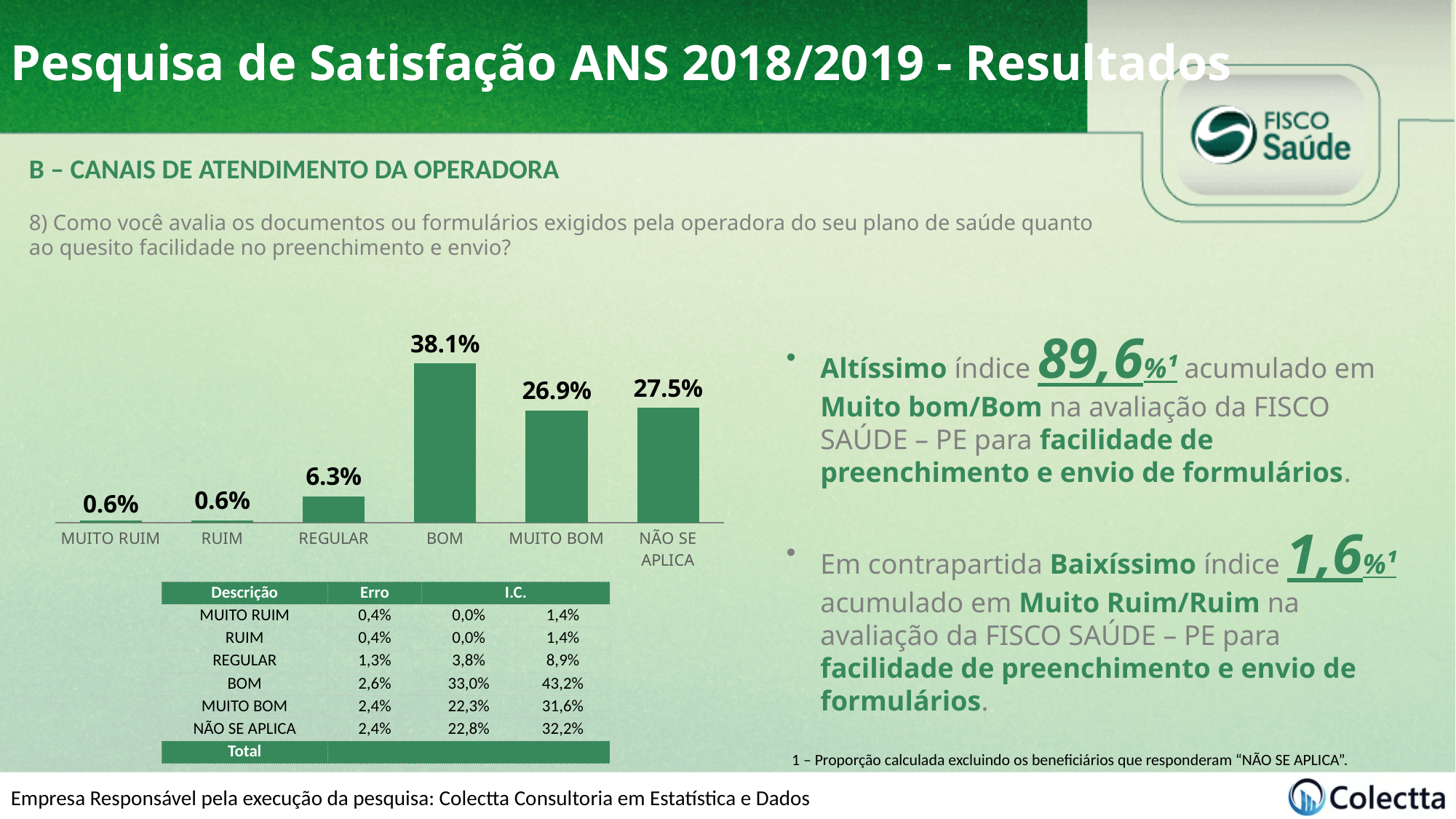
What is the combined value of BOM and MUITO BOM? 65.0% What is the value for MUITO BOM? 26.9% What is the difference between the values for BOM and MUITO BOM? 11.2% What is the value for BOM? 38.1% What is the value for NÃO SE APLICA? 27.5% What is the difference between the values for NÃO SE APLICA and REGULAR? 21.2% What is the value for REGULAR? 6.3% Which is larger, the value for NÃO SE APLICA or the value for MUITO BOM? NÃO SE APLICA How many categories are shown on the chart? 6 Which category has the highest value? BOM What kind of chart is shown on the slide? Bar chart What is the value for MUITO RUIM? 0.6%